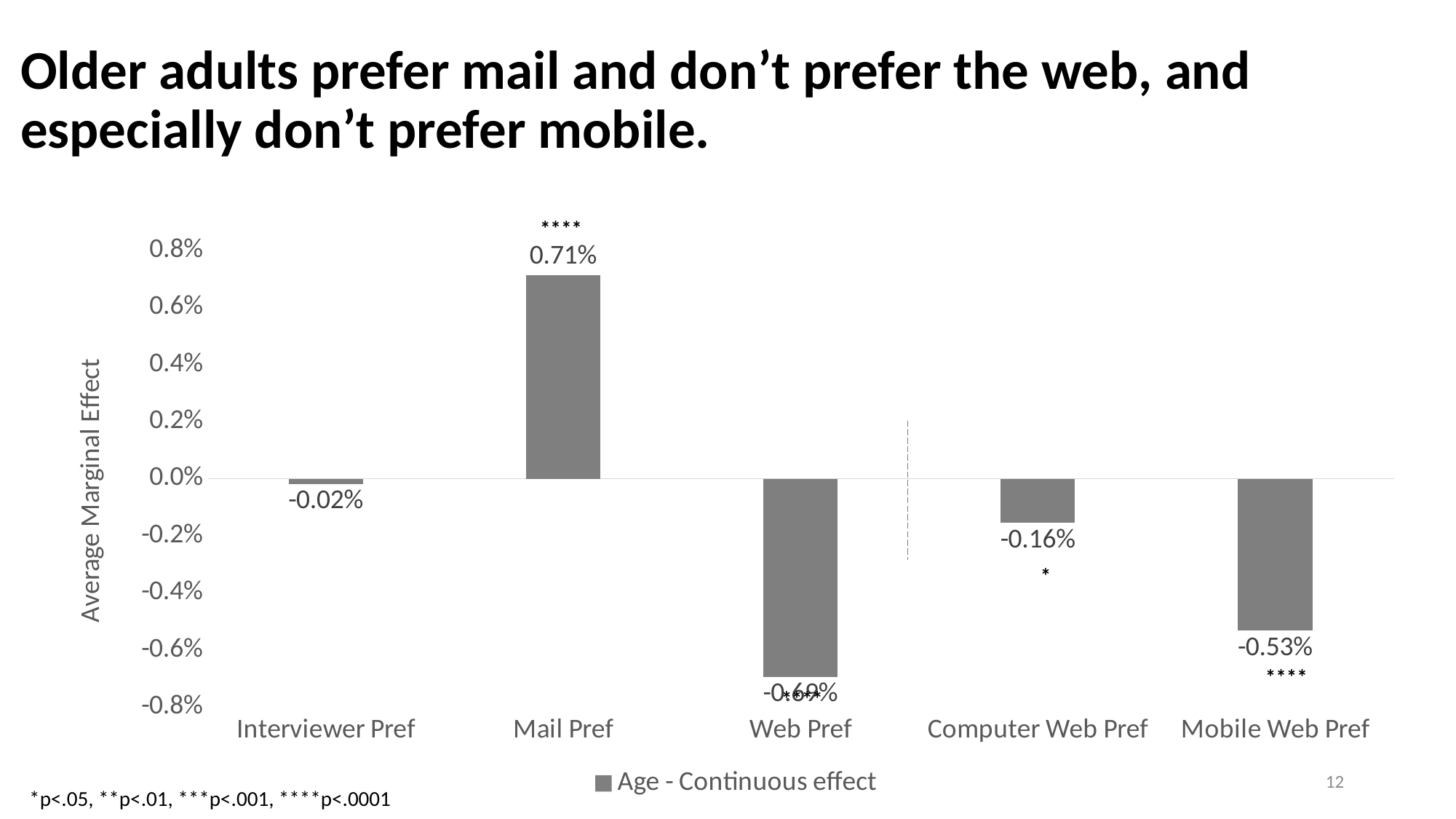
What is the value for Interviewer Pref? -0.02% Which category has the highest value? Mail Pref What is the difference between the values for Computer Web Pref and Mobile Web Pref? 0.37% How many series does the legend list? 1 How many categories are shown on the x axis? 5 What is the value for Computer Web Pref? -0.16% What is the value for Mail Pref? 0.71% Which has the higher value, Computer Web Pref or Mobile Web Pref? Computer Web Pref Which category has the lowest value? Web Pref What kind of chart is shown on the slide? bar chart Is the value for Web Pref greater or less than -0.6%? less What is the value for Mobile Web Pref? -0.53%